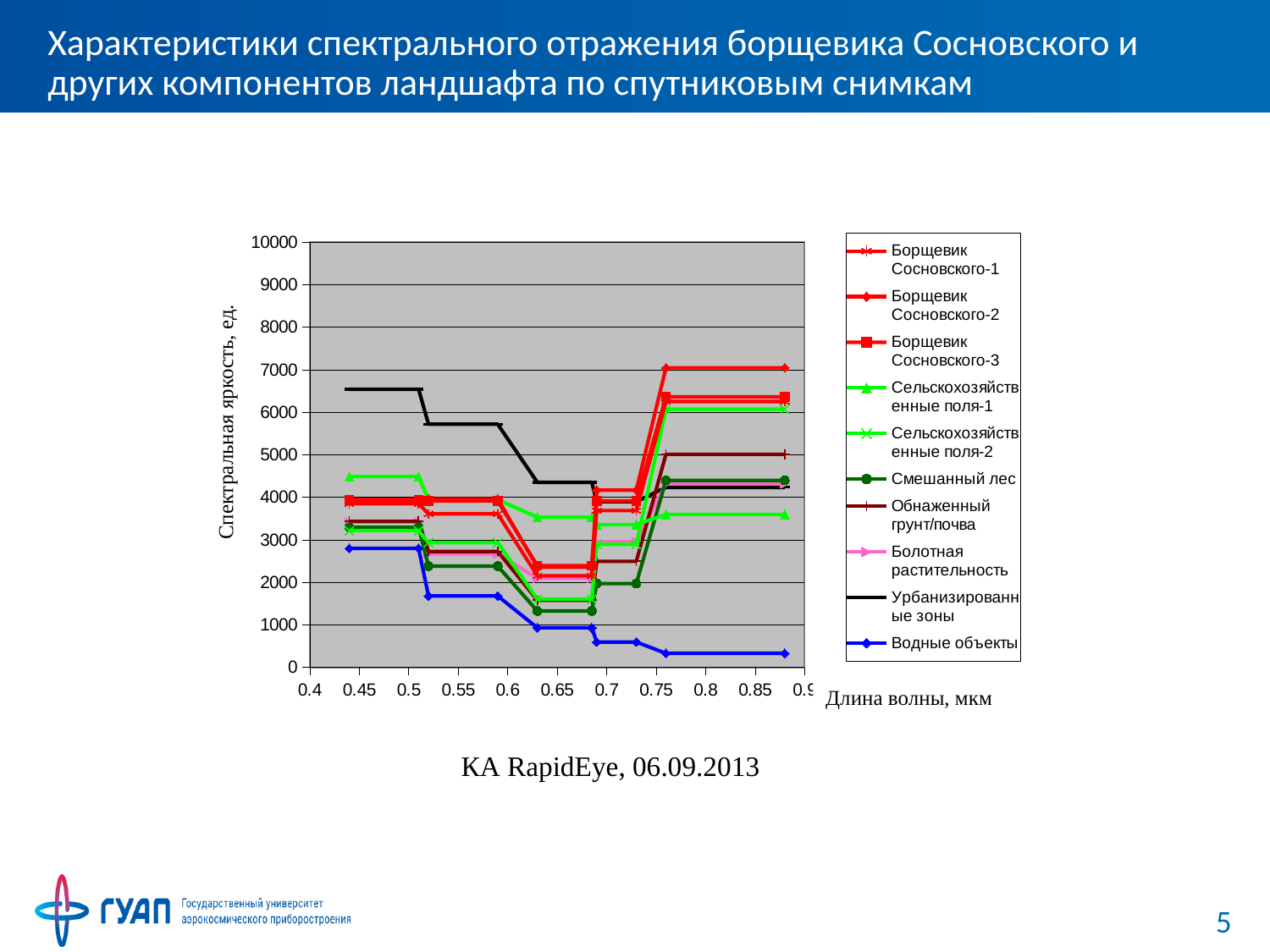
Which series has the highest value at the rightmost wavelength (around 0.88 мкм)? Борщевик Сосновского-2 Which series has the highest value at the leftmost wavelength (around 0.44 мкм)? Урбанизированные зоны What is the label of the horizontal axis? Длина волны, мкм What is the label of the vertical axis? Спектральная яркость, ед. How many series does the legend list? 10 Does the Водные объекты series rise or fall as wavelength increases along the x axis? fall Which series has the lowest value at the rightmost wavelength (around 0.88 мкм)? Водные объекты Is the value for Водные объекты at the rightmost wavelength greater or less than 1000? less At the rightmost wavelength, which is larger: Обнаженный грунт/почва or Сельскохозяйственные поля-1? Обнаженный грунт/почва At around 0.63 мкм, which is larger: Урбанизированные зоны or Водные объекты? Урбанизированные зоны What kind of chart is shown on the slide? line chart Is the value for Урбанизированные зоны at the leftmost wavelength greater or less than 6000? greater